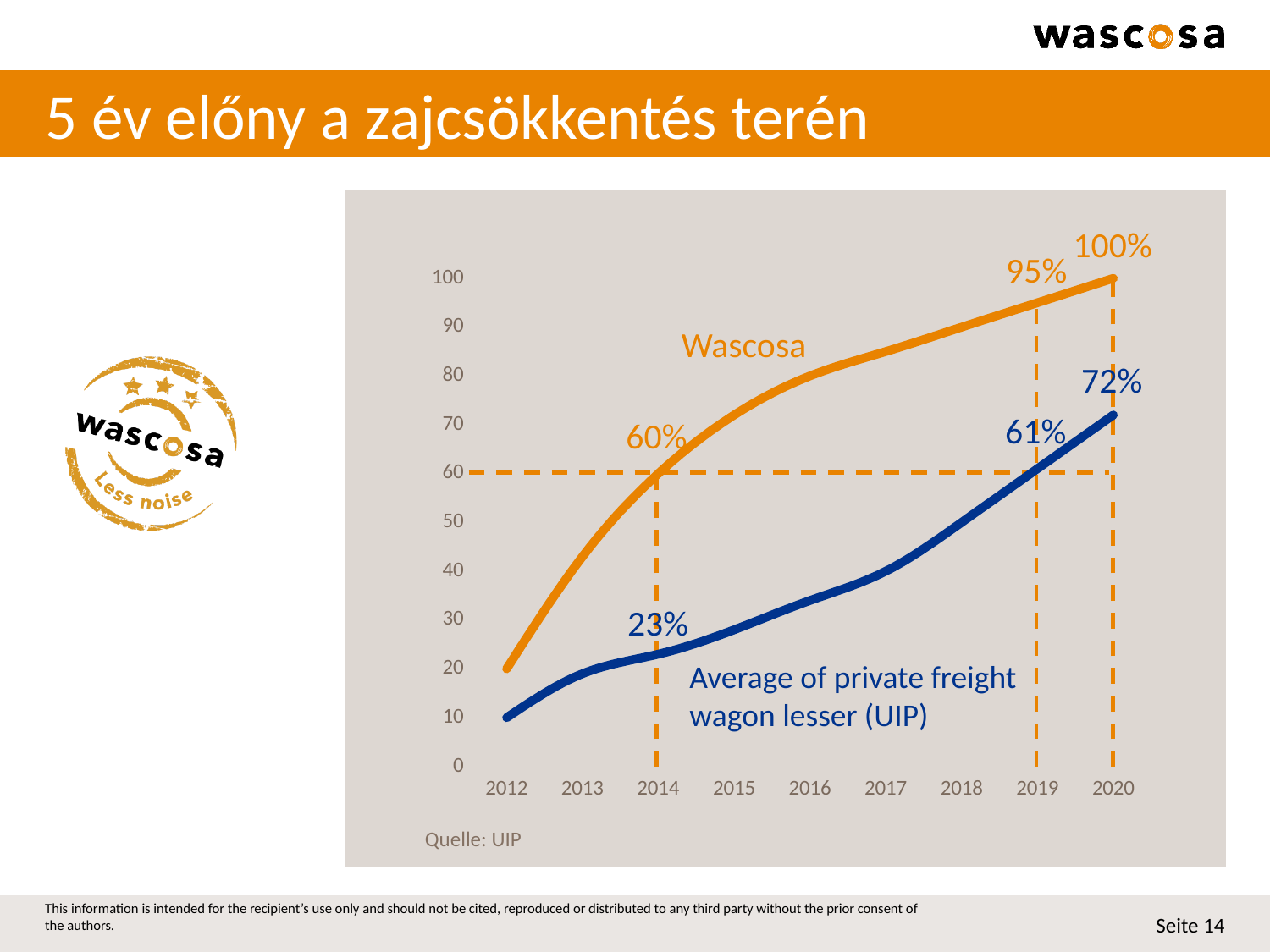
How many years are shown on the x axis? 9 Is the value for Wascosa in 2016 greater or less than 70? greater What is the value for Wascosa in 2020? 100% Is the value for Average of private freight wagon lesser (UIP) in 2012 greater or less than 20? less What is the value for Wascosa in 2014? 60% What kind of chart is shown on the slide? line chart What is the value for Wascosa in 2019? 95% Which series has the higher value in 2014, Wascosa or Average of private freight wagon lesser (UIP)? Wascosa What is the difference between the Wascosa value and the Average of private freight wagon lesser (UIP) value in 2019? 34% What is the value for Average of private freight wagon lesser (UIP) in 2020? 72% What is the value for Average of private freight wagon lesser (UIP) in 2014? 23% Do the values for Wascosa rise or fall from 2012 to 2020? rise